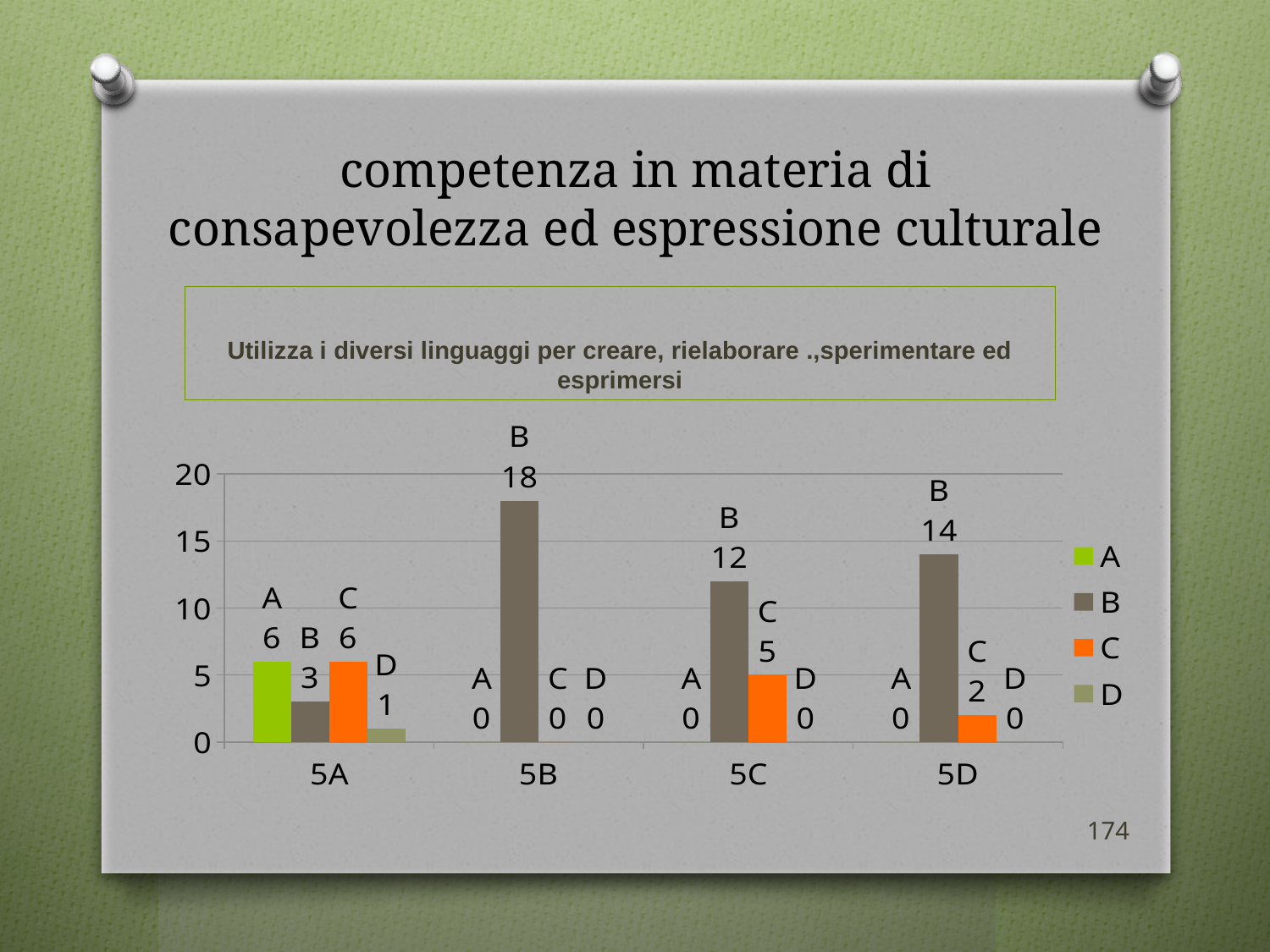
What is the value of series C for category 5C? 5 Which category has the lowest value for series B? 5A Is the value of series B for 5C greater or less than 10? greater How many series does the legend list? 4 What kind of chart is shown on the slide? bar chart How many categories are shown on the x axis? 4 What is the value of series A for category 5D? 0 Which category has the highest value for series B? 5B Which is larger: series C for 5A or series C for 5D? series C for 5A What is the value of series D for category 5A? 1 What is the difference between the series B values for 5B and 5D? 4 What is the value of series B for category 5B? 18